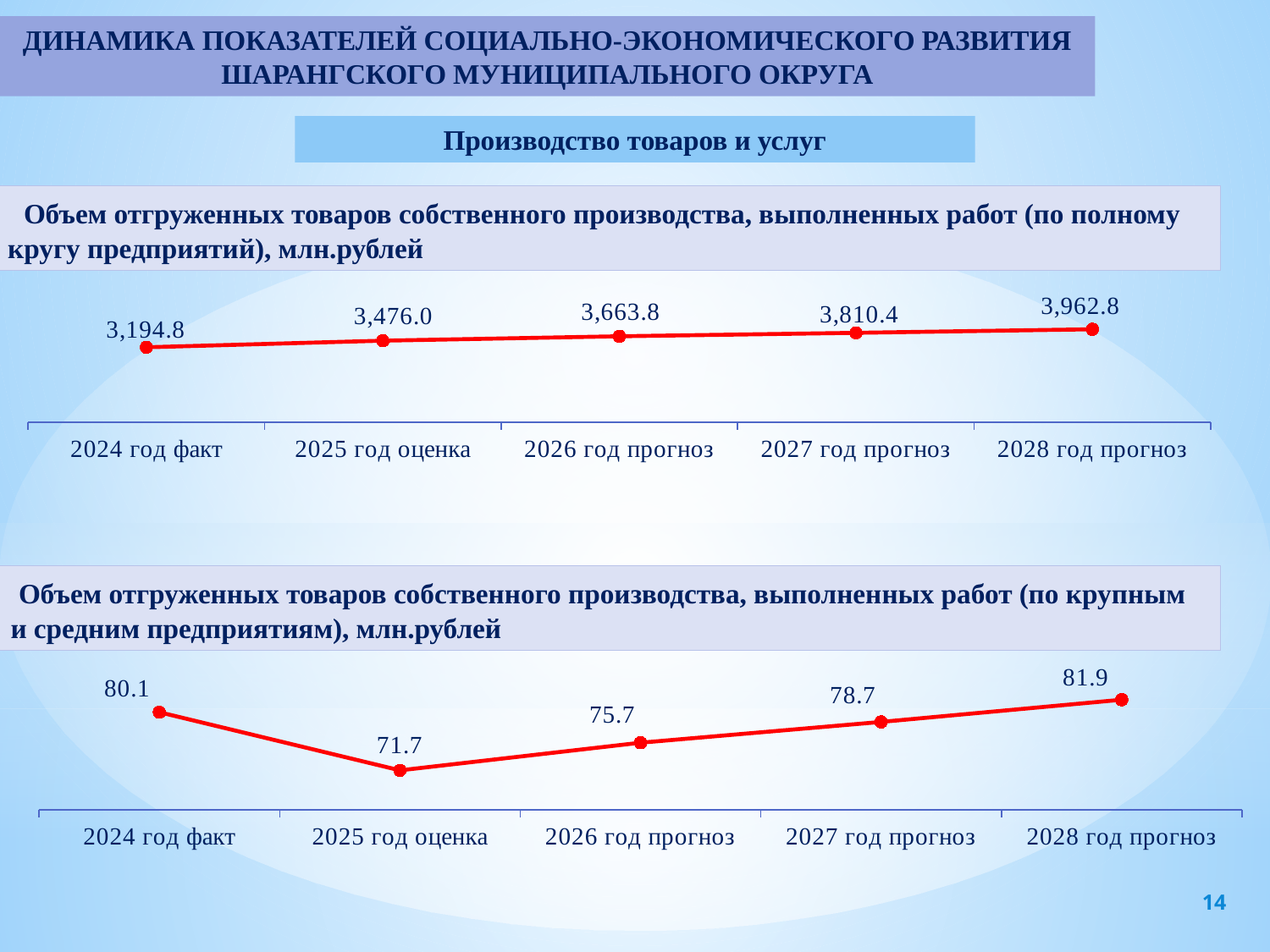
In the bottom chart (по крупным и средним предприятиям), what is the value for 2024 год факт? 80.1 How many data points are plotted in the top chart (по полному кругу предприятий)? 5 In the bottom chart (по крупным и средним предприятиям), which is larger: the value for 2026 год прогноз or the value for 2027 год прогноз? 2027 год прогноз In the bottom chart (по крупным и средним предприятиям), what is the difference between the 2024 год факт value and the 2025 год оценка value? 8.4 In the bottom chart (по крупным и средним предприятиям), what is the value for 2027 год прогноз? 78.7 In the top chart (по полному кругу предприятий), what is the difference between the 2028 год прогноз value and the 2024 год факт value? 768.0 In the top chart (по полному кругу предприятий), what is the value for 2025 год оценка? 3,476.0 In the top chart (по полному кругу предприятий), do the values rise or fall from 2024 to 2028? Rise In the bottom chart (по крупным и средним предприятиям), which year has the lowest value? 2025 год оценка In the top chart (по полному кругу предприятий), which year has the highest value? 2028 год прогноз In the top chart (по полному кругу предприятий), what is the value for 2028 год прогноз? 3,962.8 What type of chart is the bottom chart (по крупным и средним предприятиям)? Line chart